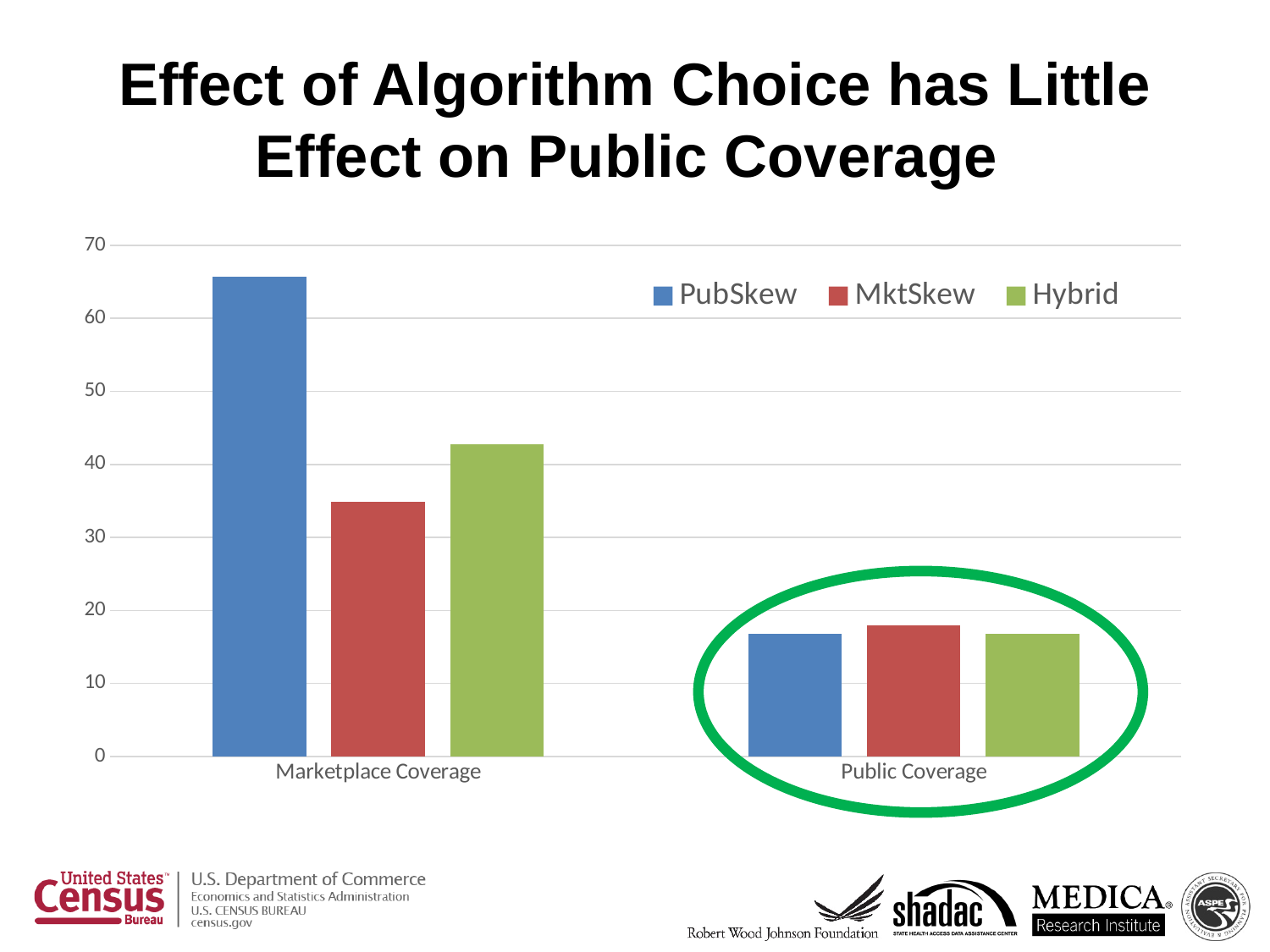
Which category has the higher PubSkew value: Marketplace Coverage or Public Coverage? Marketplace Coverage Is the PubSkew value for Marketplace Coverage greater or less than 60? greater For Marketplace Coverage, which is larger: MktSkew or Hybrid? Hybrid How many series does the legend list? 3 For Marketplace Coverage, which is larger: PubSkew or Hybrid? PubSkew What colour are the Hybrid bars? green What kind of chart is shown on the slide? bar chart How many categories are shown on the x axis? 2 Is the MktSkew value for Marketplace Coverage greater or less than 40? less Which series has the highest value for Marketplace Coverage? PubSkew Is the Hybrid value for Public Coverage greater or less than 20? less Which series has the lowest value for Marketplace Coverage? MktSkew